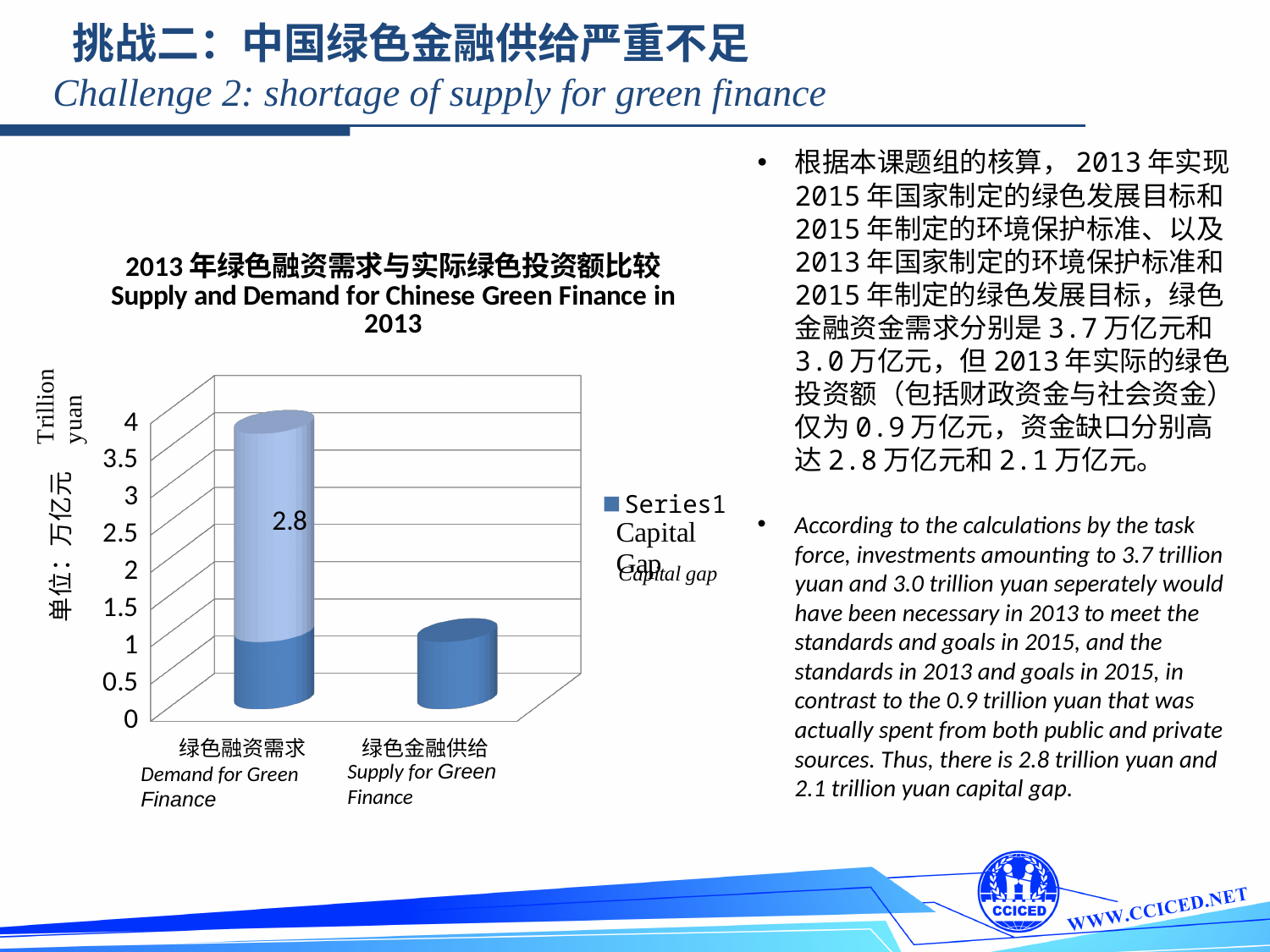
What unit is shown on the y axis of the chart? Trillion yuan Is the value for Supply for Green Finance greater or less than 1.5? less Which category has the highest total bar in the chart? Demand for Green Finance Do the bar heights rise or fall from Demand for Green Finance to Supply for Green Finance? fall How many categories are shown on the x axis of the chart? 2 How many series does the chart legend list? 2 What is the value of the Capital Gap segment labelled on the Demand for Green Finance bar? 2.8 Which category has the lowest total bar in the chart? Supply for Green Finance What is the English title of the chart? Supply and Demand for Chinese Green Finance in 2013 Is the total value for Demand for Green Finance greater or less than 3? greater Which category has the taller bar, Demand for Green Finance or Supply for Green Finance? Demand for Green Finance What type of chart is shown on the slide? bar chart